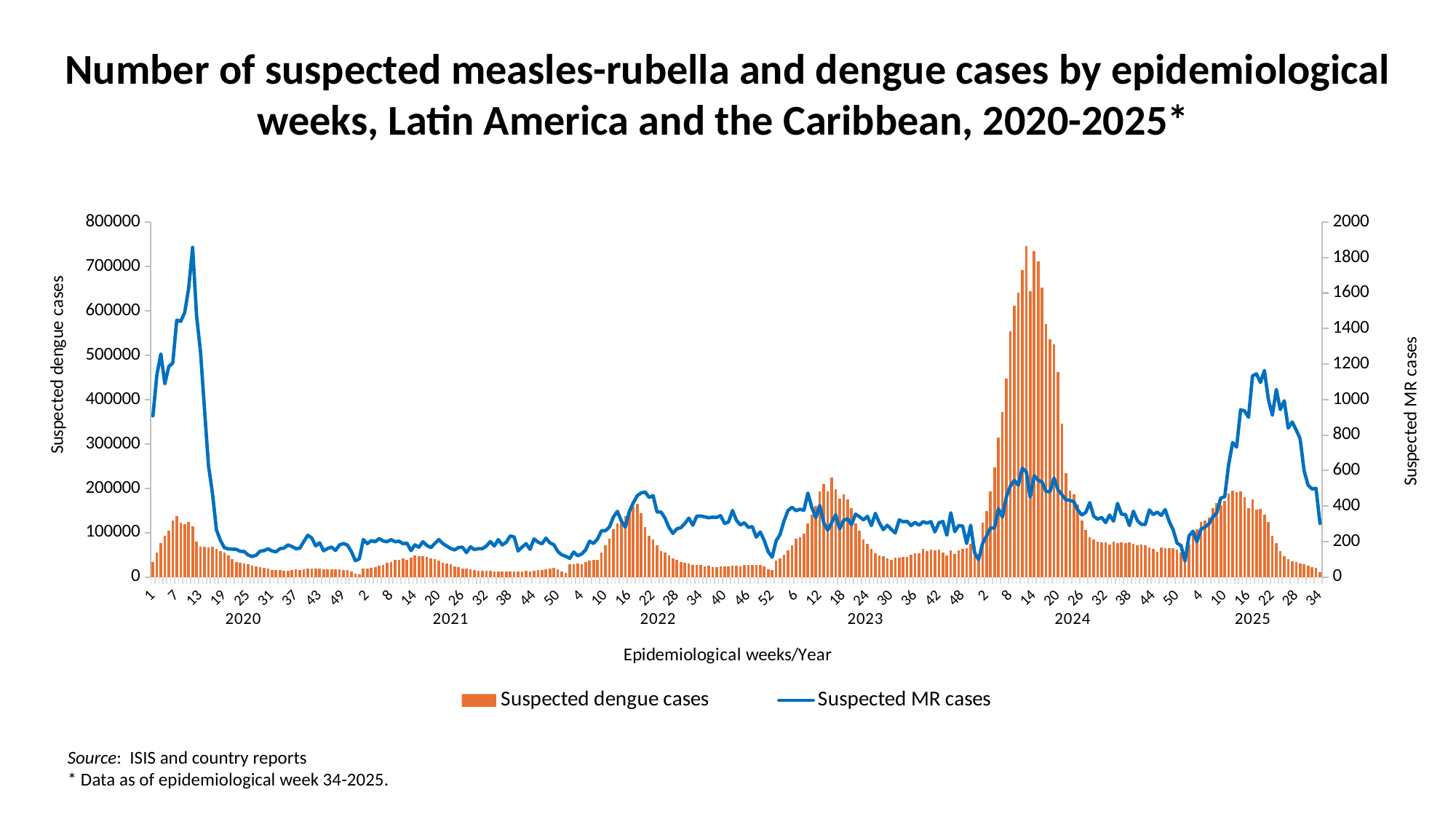
Which year has the higher peak of suspected dengue cases, 2022 or 2024? 2024 What is the title of the x axis? Epidemiological weeks/Year Do the suspected MR cases rise or fall between week 13 and week 25 of 2020? fall Is the peak of suspected dengue cases in 2023 greater or less than 300000? less In which year do the suspected dengue cases reach their highest peak? 2024 Is the peak of suspected MR cases in 2025 greater or less than 1000? greater Is the peak of suspected MR cases in 2020 greater or less than 1600? greater What are the two series named in the legend? Suspected dengue cases and Suspected MR cases In which year do the suspected MR cases reach their highest peak? 2020 What kind of chart is shown on the slide? a combined bar and line chart How many series does the legend list? 2